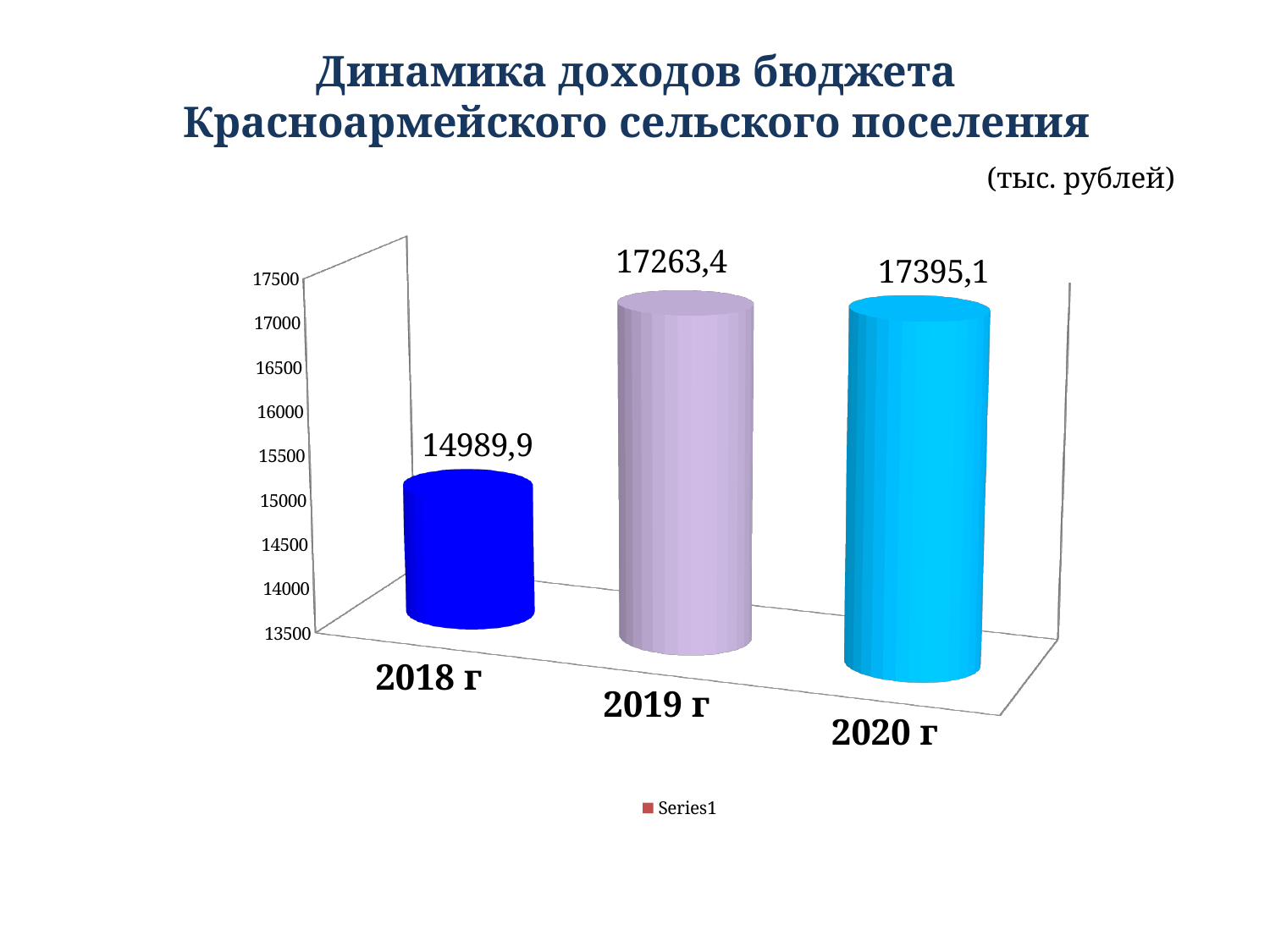
Which year has the highest budget revenue? 2020 г What is the budget revenue value shown for 2018 г? 14989,9 What is the difference between the 2019 г and 2018 г values? 2273,5 Do the values rise or fall from 2018 г to 2020 г? rise What is the difference between the 2020 г and 2019 г values? 131,7 Which is larger, the value for 2019 г or the value for 2020 г? 2020 г Which year has the lowest budget revenue? 2018 г How many years are shown on the chart? 3 How many series does the legend list? 1 What is the budget revenue value shown for 2020 г? 17395,1 What is the budget revenue value shown for 2019 г? 17263,4 Is the value for 2018 г greater or less than 15500? less